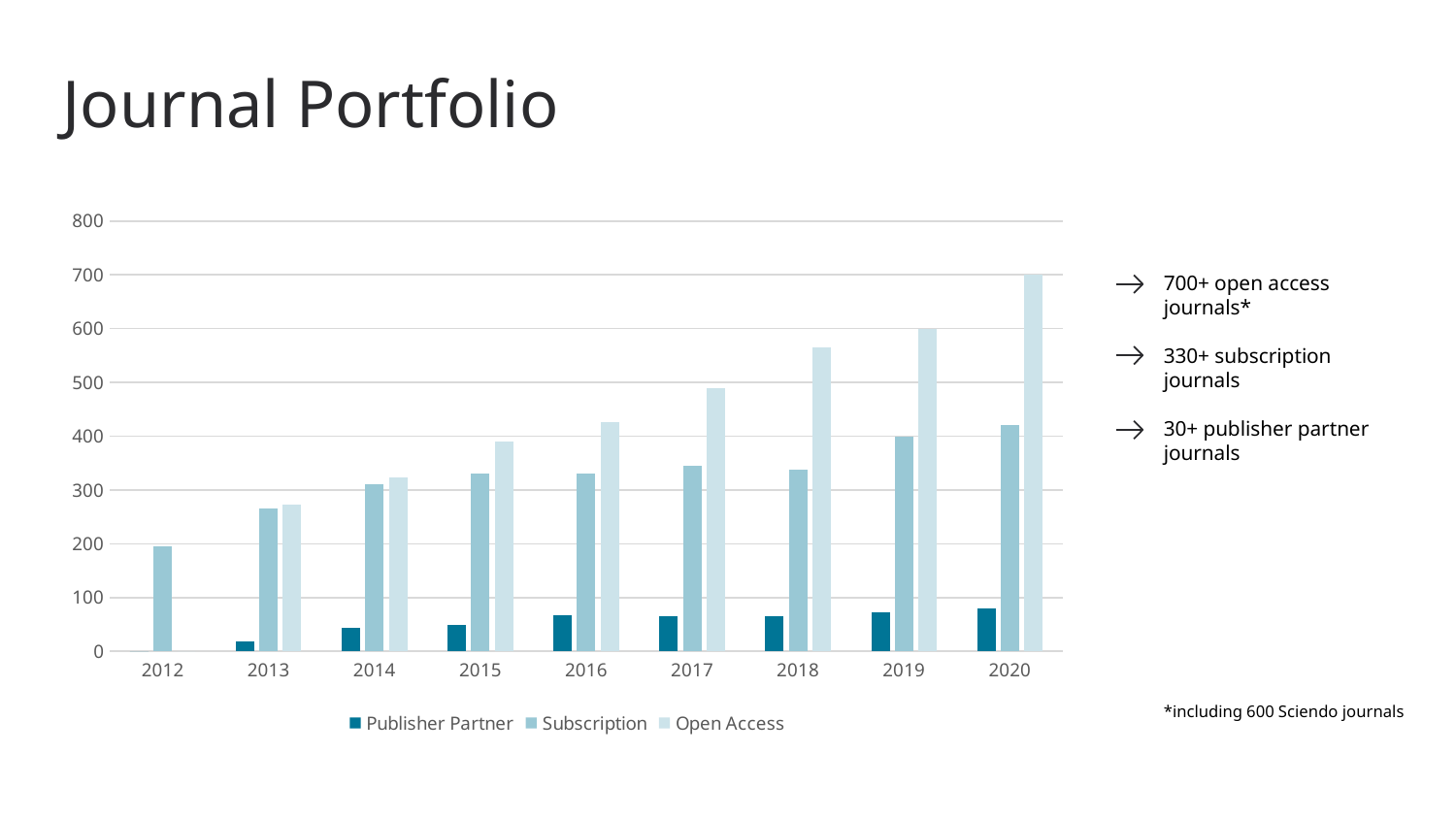
Is the Open Access value for 2018 greater or less than 500? greater Which year has the highest Open Access value? 2020 Which year has the lowest Subscription value? 2012 Is the Subscription value for 2019 greater or less than 300? greater Do the Open Access values rise or fall from 2012 to 2020? Rise What is the title of the slide containing the chart? Journal Portfolio What kind of chart is shown on the slide? Bar chart How many years are shown on the x axis? 9 In 2017, which is larger: Publisher Partner or Subscription? Subscription Is the Publisher Partner value for 2013 greater or less than 100? less How many series does the legend list? 3 In 2018, which is larger: Open Access or Subscription? Open Access